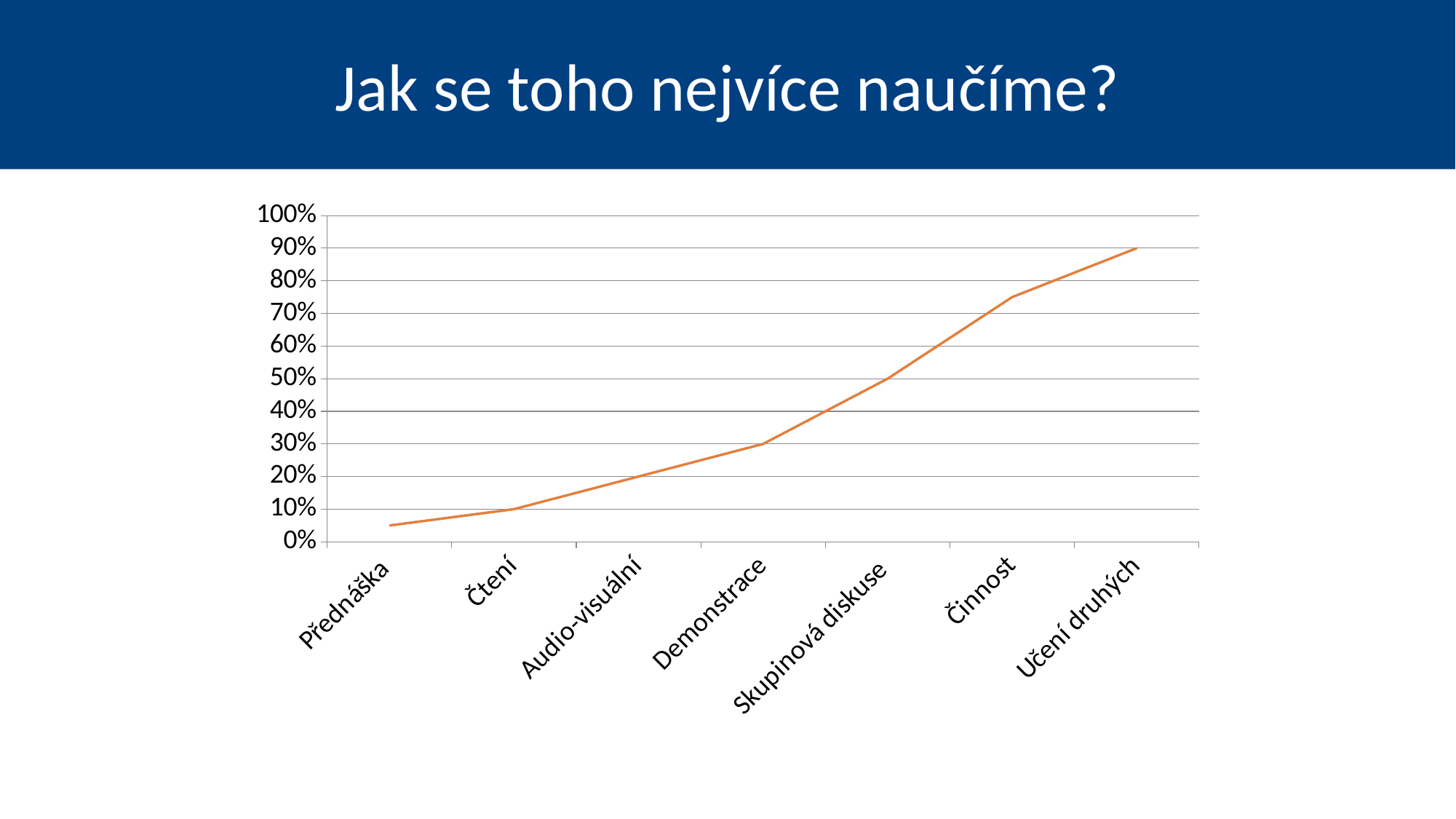
What colour is the line in the chart? orange Which category has the lowest value in the chart? Přednáška What kind of chart is shown on the slide? line chart How many categories are shown on the x axis of the chart? 7 Which has a larger value, Audio-visuální or Činnost? Činnost What is the title of the slide containing the chart? Jak se toho nejvíce naučíme? Which has a larger value, Demonstrace or Čtení? Demonstrace Is the value for Činnost greater or less than 70%? greater Is the value for Přednáška greater or less than 10%? less Is the value for Skupinová diskuse greater or less than 40%? greater Which category has the highest value in the chart? Učení druhých Do the values rise or fall along the x axis from Přednáška to Učení druhých? rise